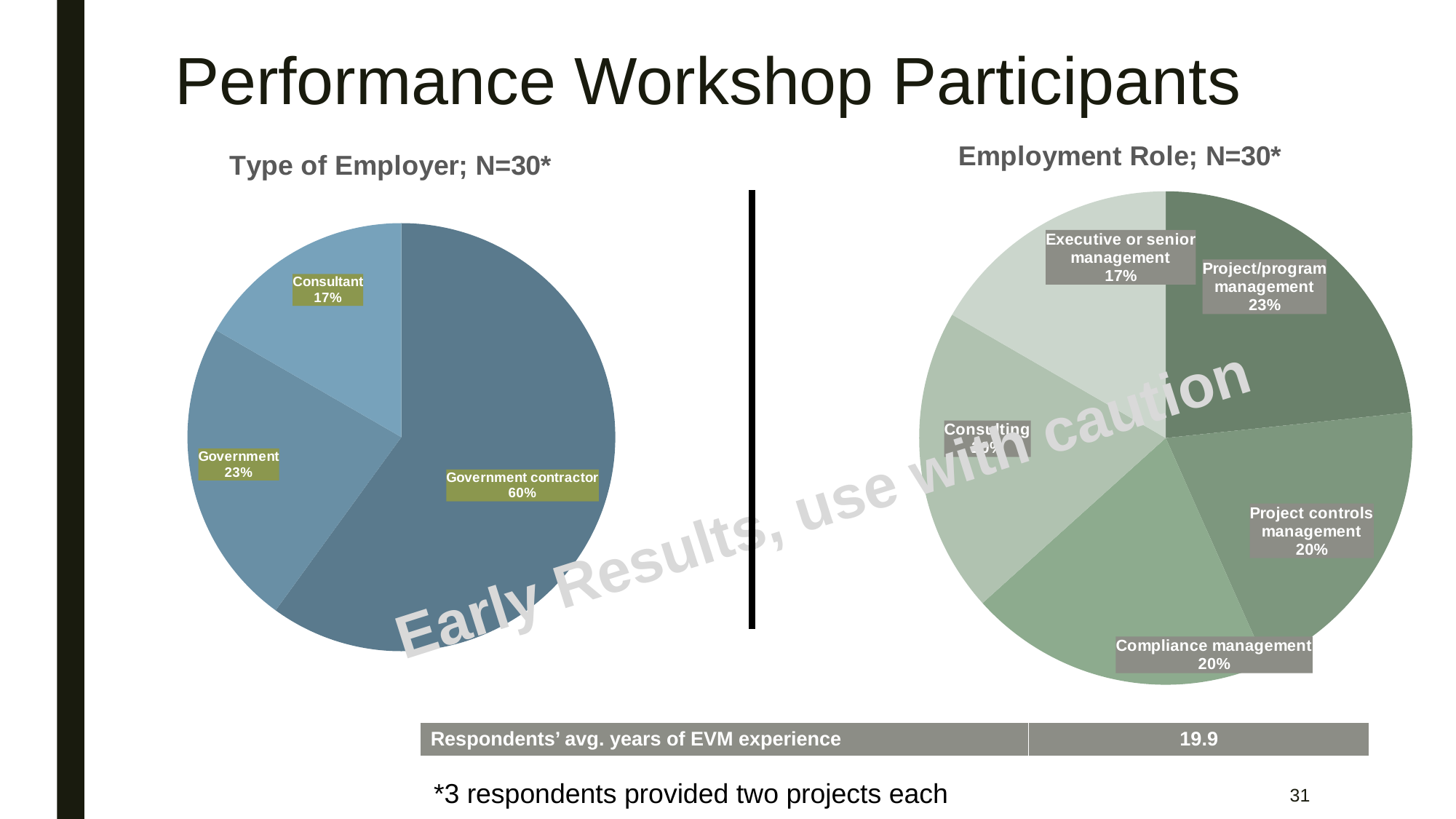
In the 'Type of Employer; N=30*' chart, which category has the largest slice? Government contractor In the 'Employment Role; N=30*' chart, what percentage is labelled Project/program management? 23% In the 'Type of Employer; N=30*' chart, what percentage is labelled Consultant? 17% In the 'Type of Employer; N=30*' chart, what percentage is labelled Government? 23% In the 'Type of Employer; N=30*' chart, how many percentage points larger is Government contractor than Government? 37 In the 'Type of Employer; N=30*' chart, which category has the smallest slice? Consultant In the 'Type of Employer; N=30*' chart, what share of participants are Government contractors? 60% In the 'Employment Role; N=30*' chart, what percentage is labelled Compliance management? 20% In the 'Employment Role; N=30*' chart, which is larger: Project controls management or Executive or senior management? Project controls management What kind of chart is the 'Employment Role; N=30*' chart? Pie chart In the 'Type of Employer; N=30*' chart, how many categories are shown? 3 In the 'Employment Role; N=30*' chart, what percentage is labelled Executive or senior management? 17%